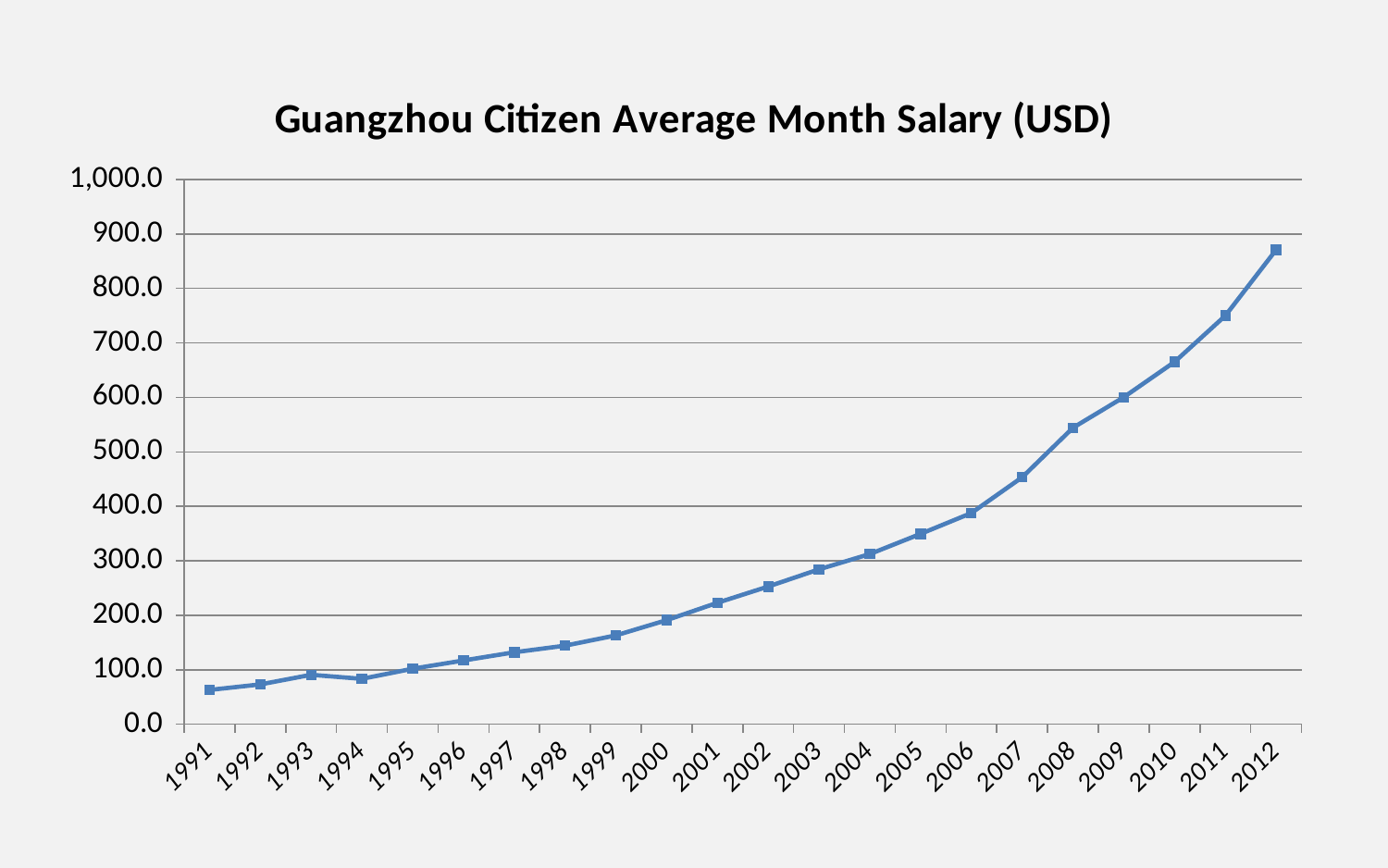
What kind of chart is shown on the slide? line chart Is the value for 2005 greater or less than 400? less Which year has the highest average monthly salary? 2012 Which year has the lowest average monthly salary? 1991 Is the value for 2012 greater or less than 800? greater Is the value for 2007 greater or less than 500? less Do the values generally rise or fall from 1991 to 2012? rise Which year has the higher value, 1993 or 1994? 1993 What is the title of the chart? Guangzhou Citizen Average Month Salary (USD) How many years are plotted on the x axis? 22